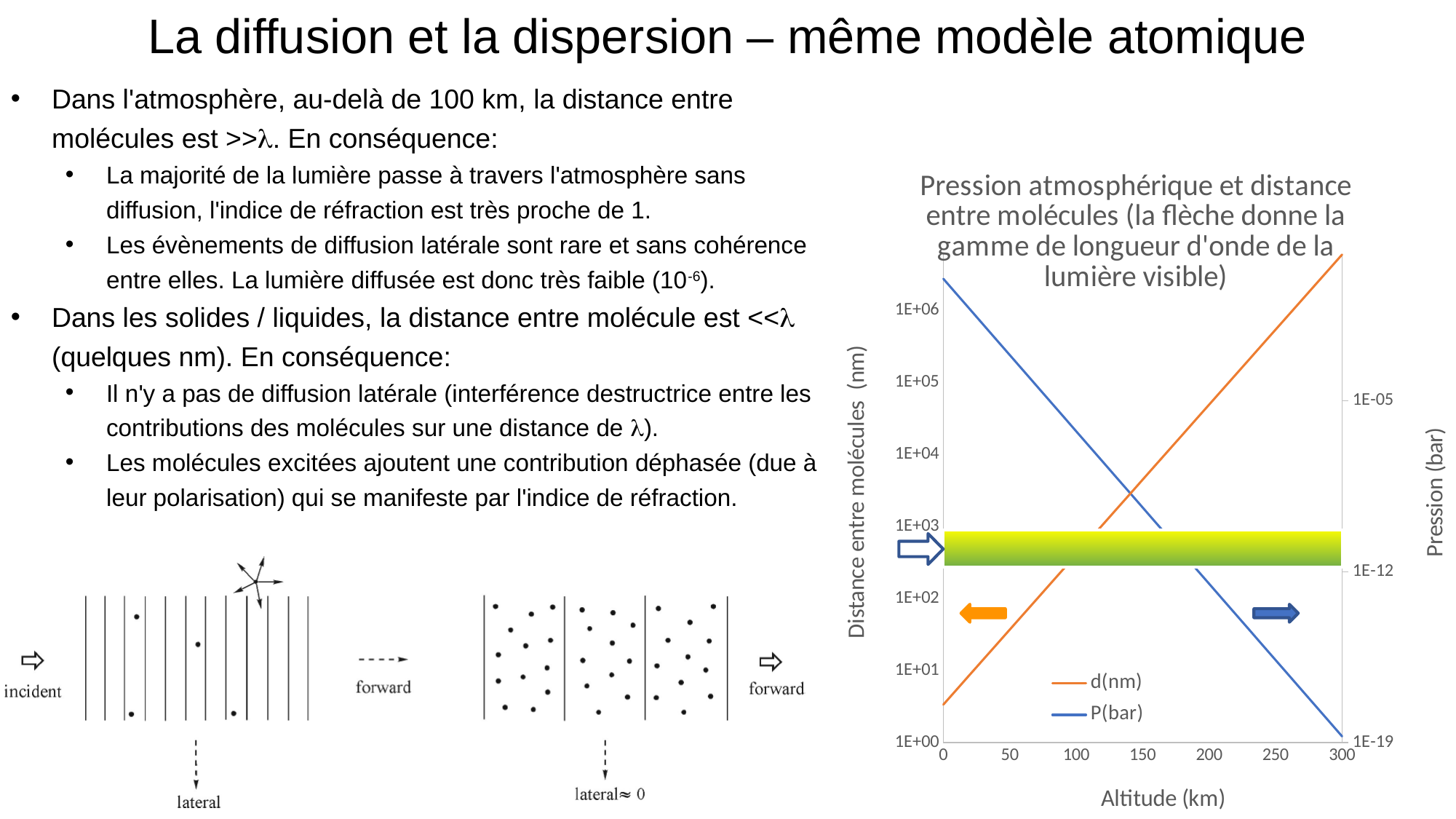
What is the label of the x axis of the chart? Altitude (km) Does the P(bar) series rise or fall as altitude increases? fall What are the two series named in the chart legend? d(nm) and P(bar) Is the value of P(bar) at altitude 300 km greater or less than 1E-12? less Is the value of P(bar) at altitude 0 km greater or less than 1E-05? greater Does the d(nm) series rise or fall as altitude increases? rise What kind of chart is shown on the slide? line chart Is the value of d(nm) at altitude 0 km greater or less than 1E+01? less What is the maximum altitude shown on the x axis of the chart? 300 How many series does the chart legend list? 2